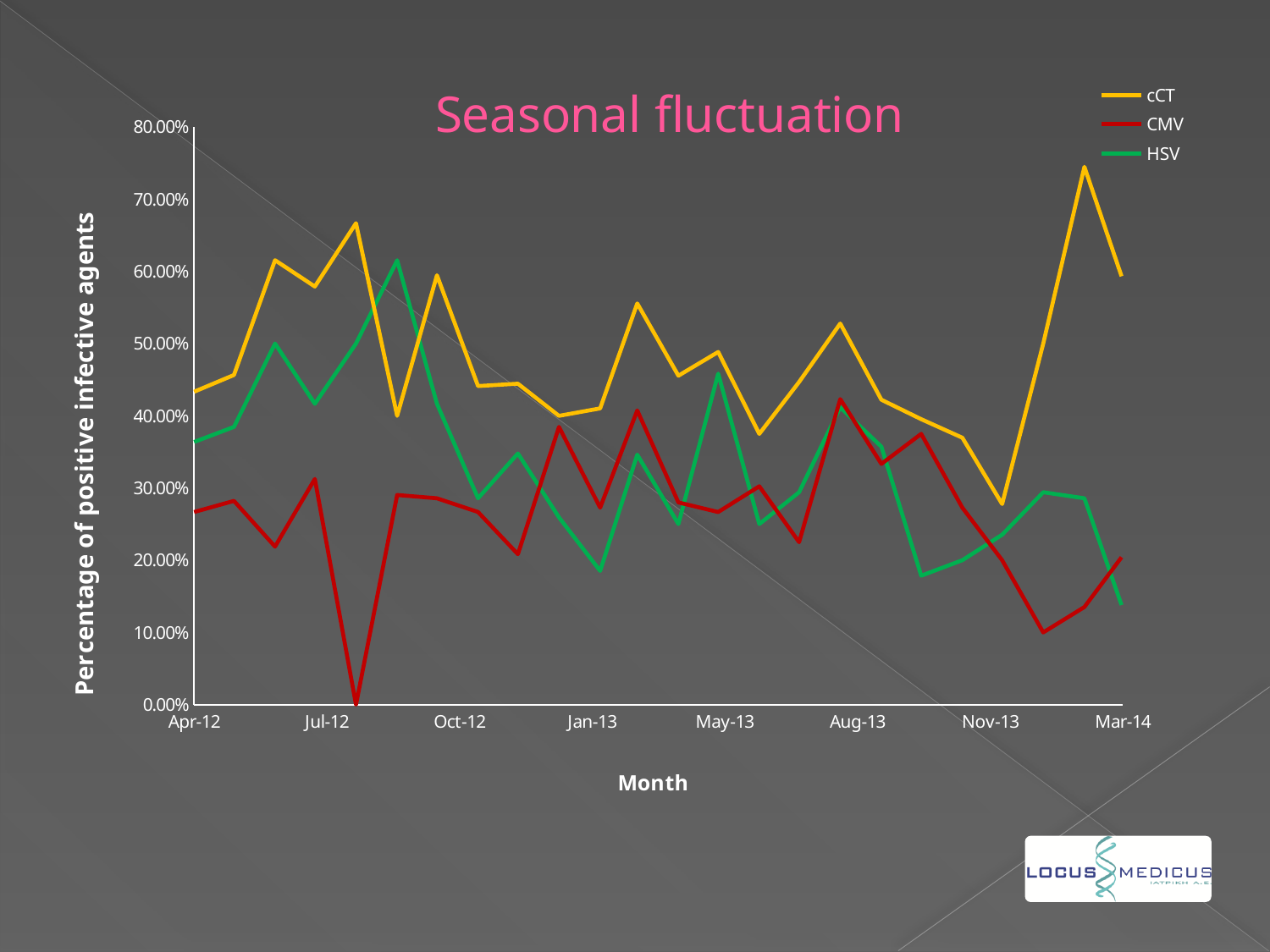
What is the label of the vertical axis? Percentage of positive infective agents How many series does the legend list? 3 What is the title of the chart? Seasonal fluctuation At Apr-12, which series has the larger value, cCT or CMV? cCT Is the value for cCT at Apr-12 greater or less than 40.00%? greater Which series reaches the highest value on the chart? cCT Is the value for HSV at Mar-14 greater or less than 20.00%? less Is the value for cCT at Mar-14 greater or less than 50.00%? greater At Mar-14, which series has the larger value, CMV or HSV? CMV What kind of chart is shown on the slide? line chart What is the value of the CMV series at its lowest point? 0.00% Which series drops to the lowest value on the chart? CMV